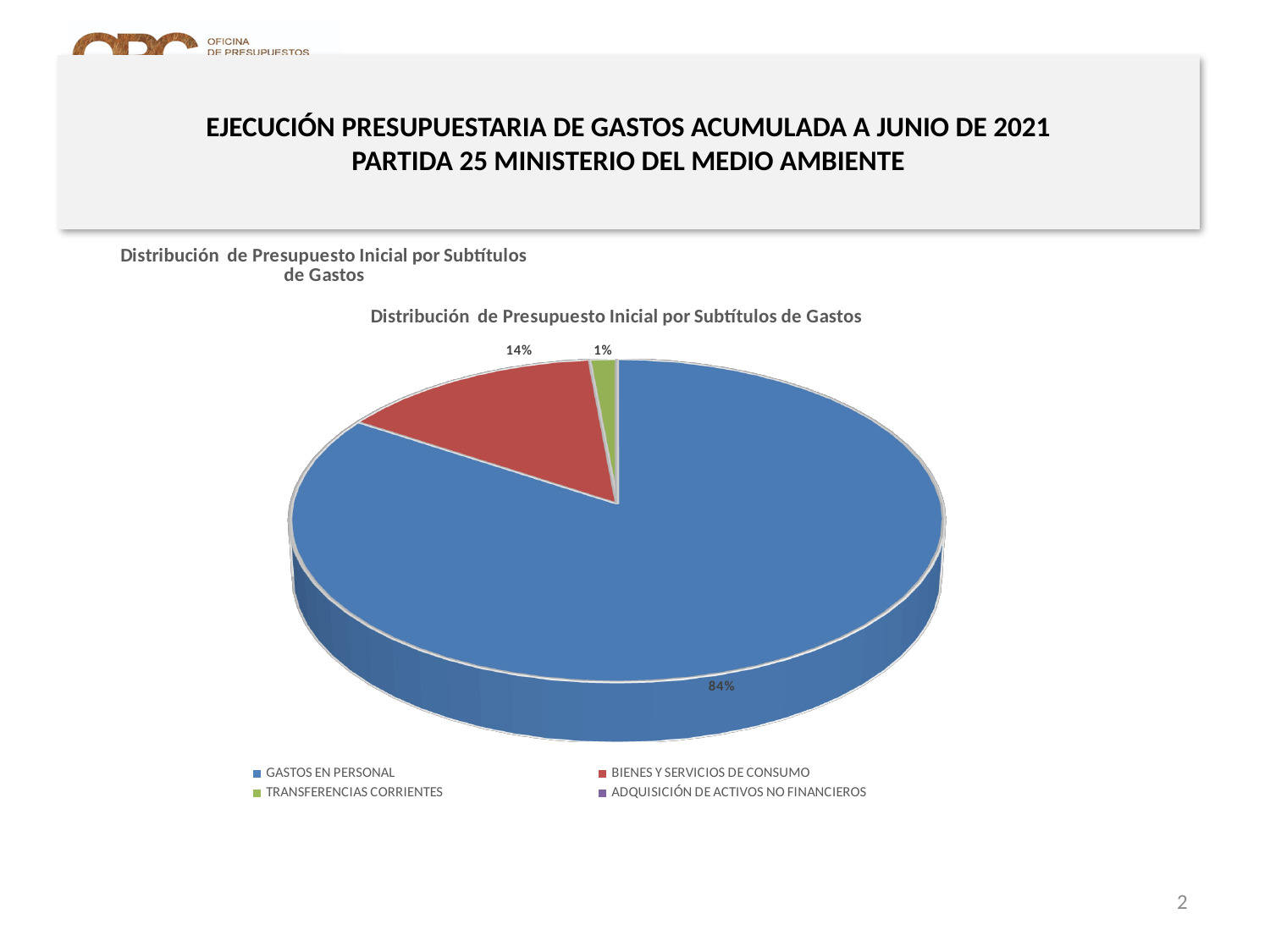
What is the title of the chart? Distribución de Presupuesto Inicial por Subtítulos de Gastos Which category has the largest slice of the pie? GASTOS EN PERSONAL What is the difference in percentage points between GASTOS EN PERSONAL and BIENES Y SERVICIOS DE CONSUMO? 70 percentage points Which is larger, the slice for BIENES Y SERVICIOS DE CONSUMO or the slice for TRANSFERENCIAS CORRIENTES? BIENES Y SERVICIOS DE CONSUMO What is the difference in percentage points between BIENES Y SERVICIOS DE CONSUMO and TRANSFERENCIAS CORRIENTES? 13 percentage points What share of the pie does GASTOS EN PERSONAL represent? 84% What kind of chart is shown on the slide? Pie chart What colour is the slice for GASTOS EN PERSONAL? Blue What percentage is shown for BIENES Y SERVICIOS DE CONSUMO? 14% What percentage is shown for TRANSFERENCIAS CORRIENTES? 1% How many categories does the legend list? 4